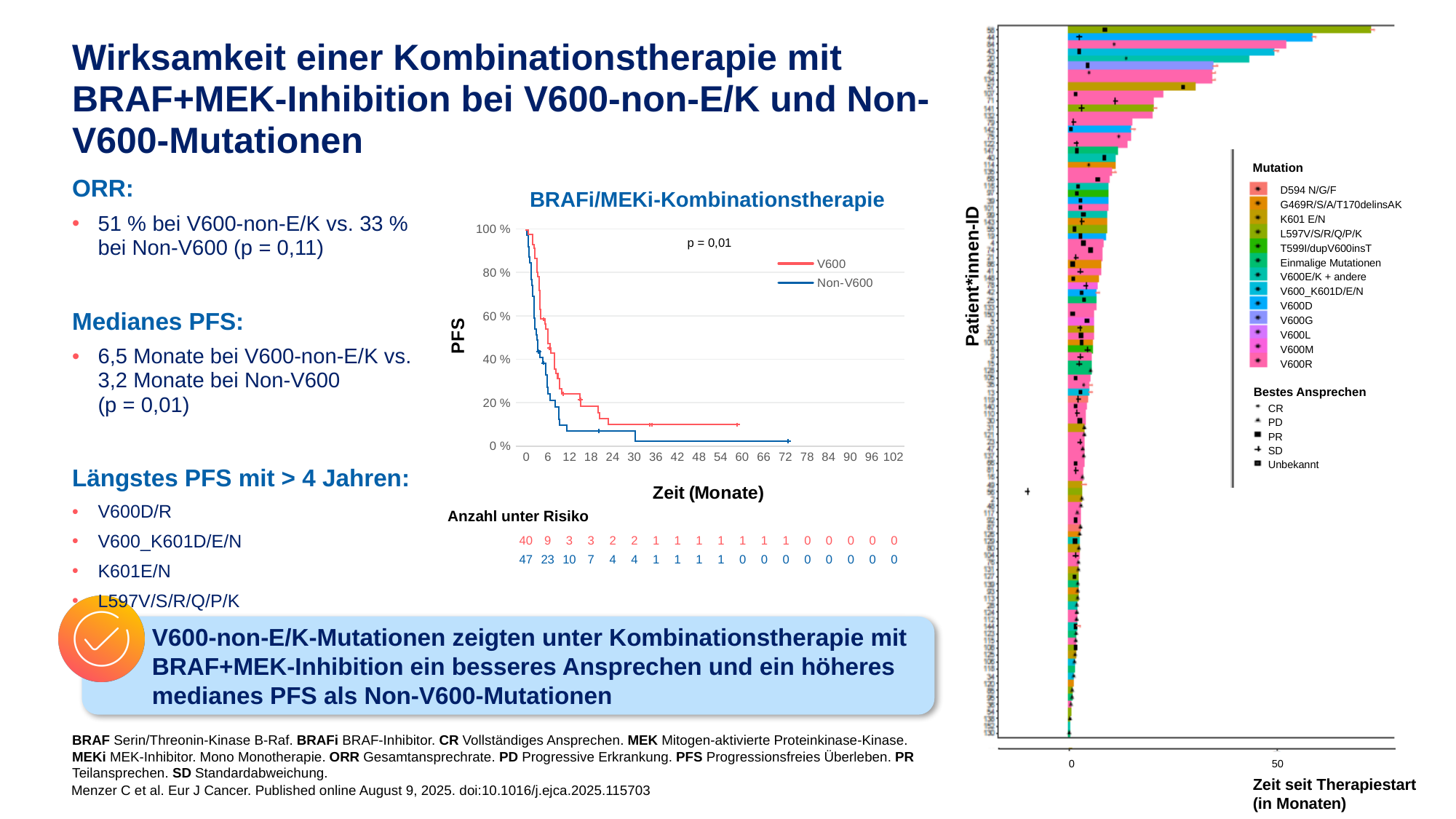
In the 'BRAFi/MEKi-Kombinationstherapie' chart, which colour is the V600 line? red In the 'BRAFi/MEKi-Kombinationstherapie' chart, do the PFS curves rise or fall as time increases? fall In the 'BRAFi/MEKi-Kombinationstherapie' chart, is the V600 PFS value at 36 months greater or less than 20 %? less In the 'Anzahl unter Risiko' table below the 'BRAFi/MEKi-Kombinationstherapie' chart, how many Non-V600 patients are at risk at 0 months? 47 In the 'BRAFi/MEKi-Kombinationstherapie' chart, what p-value is printed on the plot? p = 0,01 In the 'Anzahl unter Risiko' table below the 'BRAFi/MEKi-Kombinationstherapie' chart, how many Non-V600 patients are at risk at 6 months? 23 In the 'Anzahl unter Risiko' table below the 'BRAFi/MEKi-Kombinationstherapie' chart, which group has more patients at risk at 12 months, V600 or Non-V600? Non-V600 In the 'Anzahl unter Risiko' table below the 'BRAFi/MEKi-Kombinationstherapie' chart, how many V600 patients are at risk at 0 months? 40 In the chart titled 'BRAFi/MEKi-Kombinationstherapie', how many series does the legend list? 2 What kind of chart is the 'BRAFi/MEKi-Kombinationstherapie' chart? line chart In the 'Anzahl unter Risiko' table below the 'BRAFi/MEKi-Kombinationstherapie' chart, what is the difference between the Non-V600 and V600 numbers at risk at 0 months? 7 In the swimmer plot on the right of the slide, how many entries does the 'Mutation' legend list? 13